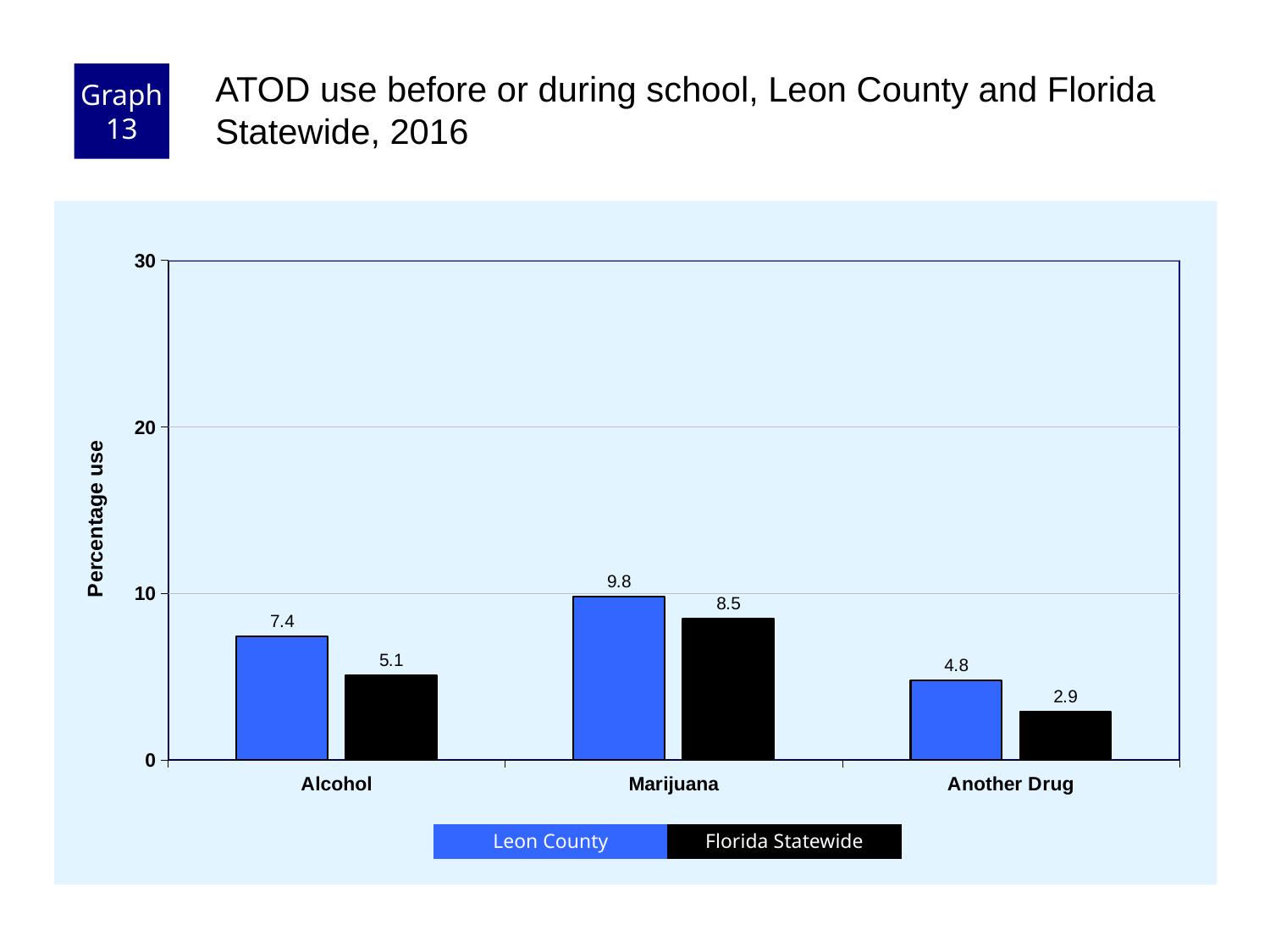
Is the Leon County value for Marijuana greater or less than 10? less How many series does the legend list? 2 Which is larger for Another Drug, Leon County or Florida Statewide? Leon County What is the Leon County value for Alcohol? 7.4 What kind of chart is shown on the slide? bar chart What is the difference between the Leon County values for Marijuana and Another Drug? 5.0 What is the Florida Statewide value for Marijuana? 8.5 What is the Florida Statewide value for Another Drug? 2.9 Which category has the lowest Florida Statewide value? Another Drug Which category has the highest Leon County value? Marijuana How many categories are shown on the x axis? 3 What is the difference between the Leon County and Florida Statewide values for Alcohol? 2.3